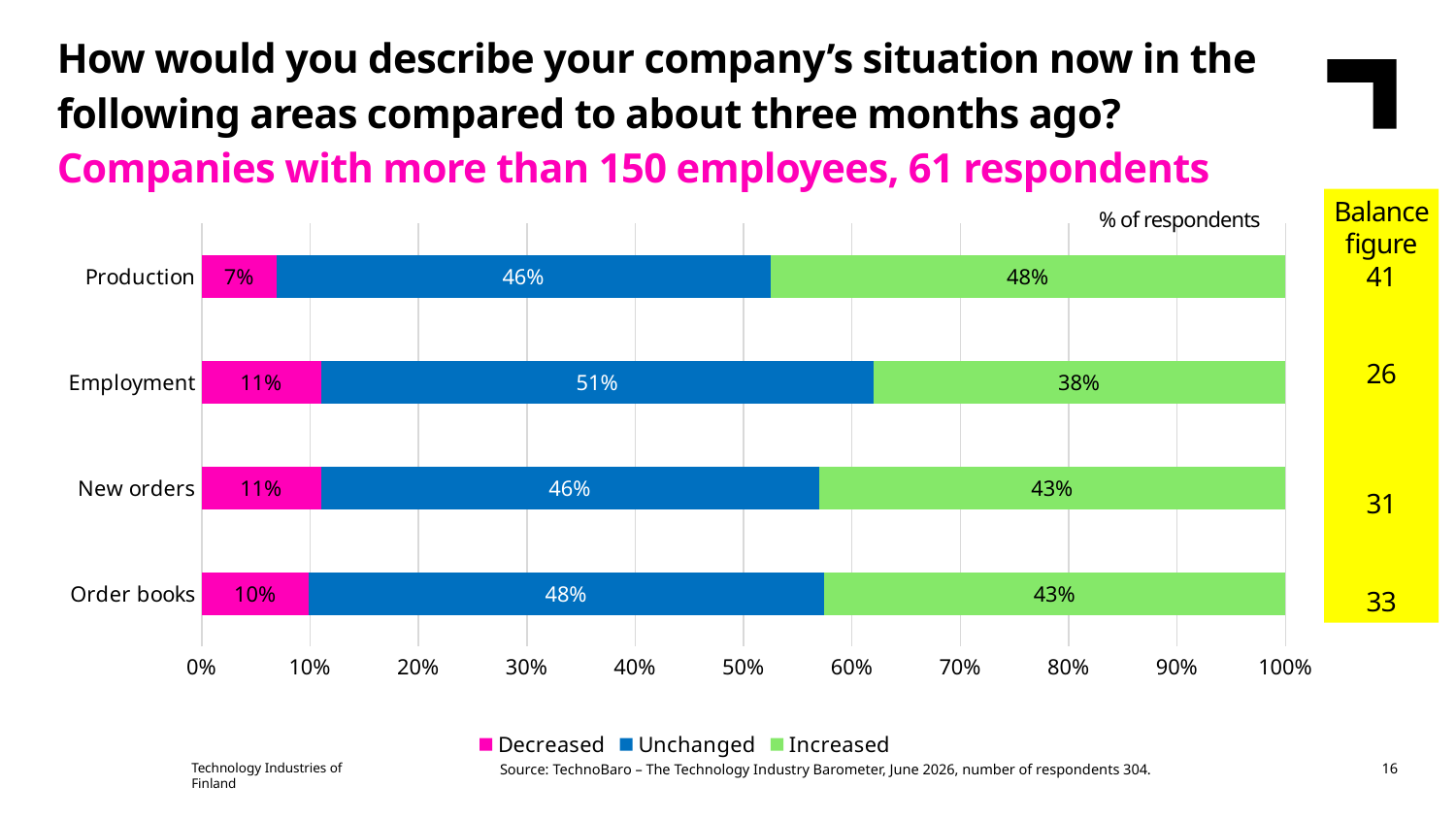
What is the difference between the 'Increased' share for Production and the 'Increased' share for Employment? 10 percentage points Which category has the highest share of respondents reporting 'Increased'? Production What kind of chart is shown on the slide? Stacked bar chart Which category has the lowest share of respondents reporting 'Decreased'? Production Is the 'Unchanged' share larger for Employment or for New orders? Employment How many series does the legend list? 3 What percentage of respondents reported that Production increased? 48% What percentage of respondents reported that Employment was unchanged? 51% What percentage of respondents reported that Order books decreased? 10% Which colour represents the 'Decreased' series in the legend? Pink (magenta) How many categories are shown on the chart? 4 What is the balance figure shown for New orders? 31